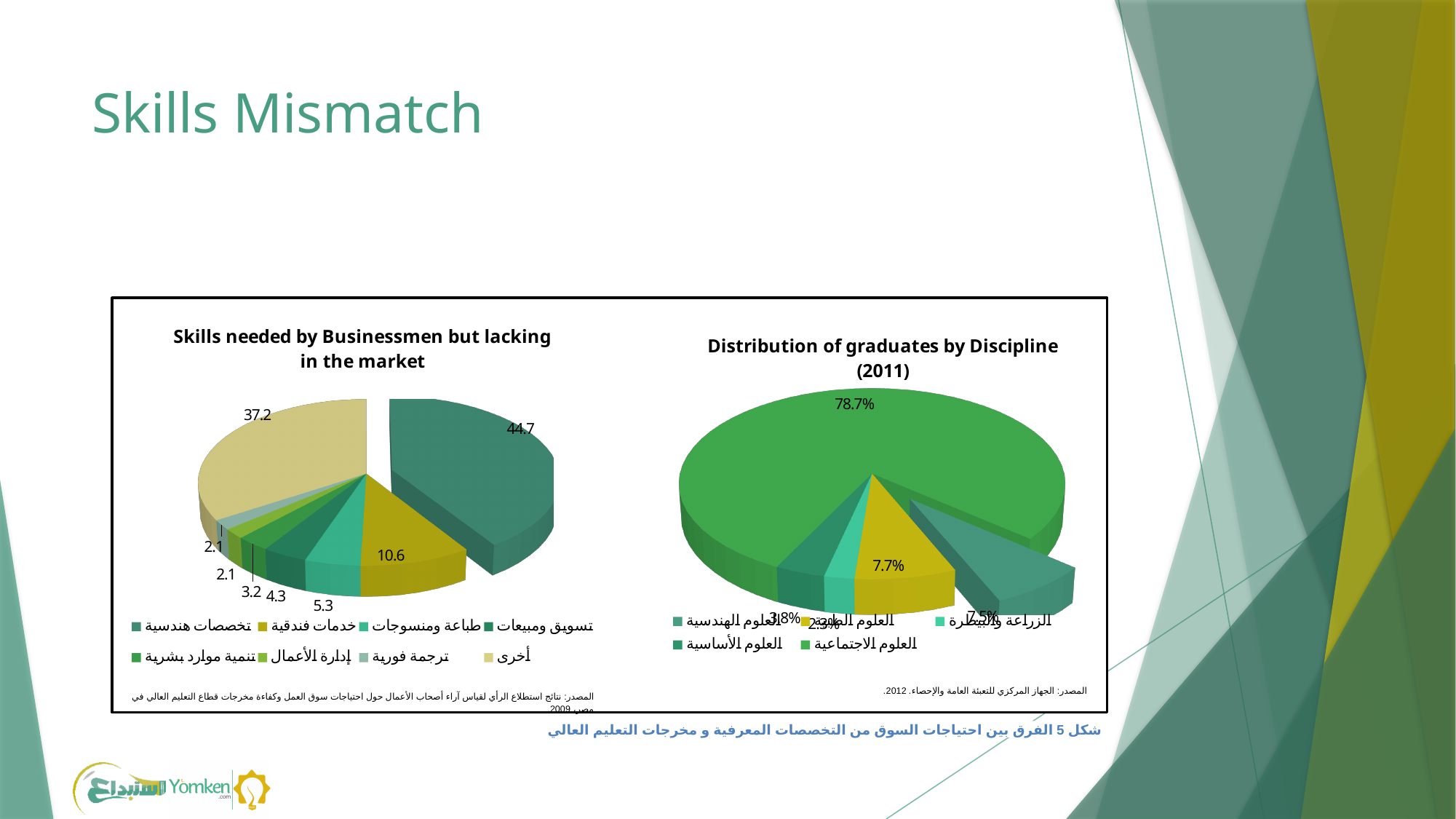
In the left chart 'Skills needed by Businessmen but lacking in the market', what is the difference between the largest slice (44.7) and the slice labelled 37.2? 7.5 In the right chart 'Distribution of graduates by Discipline (2011)', what share is shown for the yellow slice, العلوم الطبية (medical sciences)? 7.7% In the left chart 'Skills needed by Businessmen but lacking in the market', which is larger: the slice labelled 5.3 or the slice labelled 4.3? 5.3 In the right chart 'Distribution of graduates by Discipline (2011)', what is the difference between the 78.7% slice and the 7.7% slice? 71.0% How many entries does the legend of the left chart 'Skills needed by Businessmen but lacking in the market' list? 8 What type of chart is the left chart, 'Skills needed by Businessmen but lacking in the market'? Pie chart What year is given in the title of the right chart, 'Distribution of graduates by Discipline'? 2011 How many disciplines does the legend of the right chart 'Distribution of graduates by Discipline (2011)' list? 5 In the left chart 'Skills needed by Businessmen but lacking in the market', what value is shown for the beige slice labelled أخرى (other)? 37.2 In the right chart 'Distribution of graduates by Discipline (2011)', what share is shown for the largest slice, العلوم الاجتماعية (social sciences)? 78.7% In the left chart 'Skills needed by Businessmen but lacking in the market', what is the largest value shown? 44.7 In the left chart 'Skills needed by Businessmen but lacking in the market', what value is shown for the olive slice labelled خدمات فندقية (hotel services)? 10.6